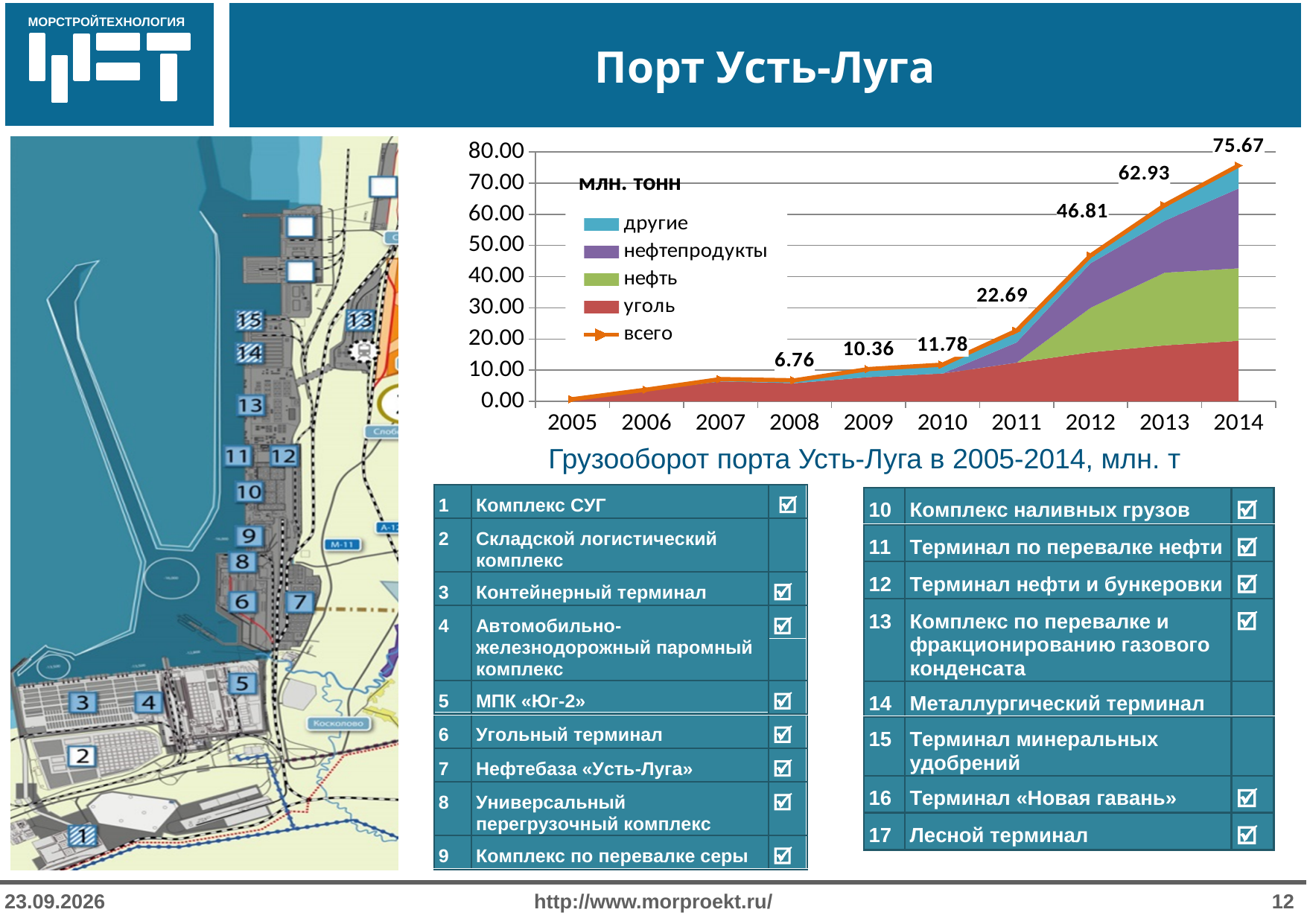
What is the value of the 'всего' series for 2014? 75.67 How many series does the chart legend list? 5 How many years are shown on the x axis of the chart? 10 What is the difference between the 'всего' values for 2010 and 2009? 1.42 In which year is the 'всего' value highest? 2014 What is the value of the 'всего' series for 2008? 6.76 What is the value of the 'всего' series for 2011? 22.69 What is the caption below the chart? Грузооборот порта Усть-Луга в 2005-2014, млн. т Is the 'всего' value for 2007 greater or less than 10.00? less Which is larger, the 'всего' value for 2012 or for 2011? 2012 What is the difference between the 'всего' values for 2013 and 2012? 16.12 Does the 'всего' series rise or fall from 2008 to 2014? rise